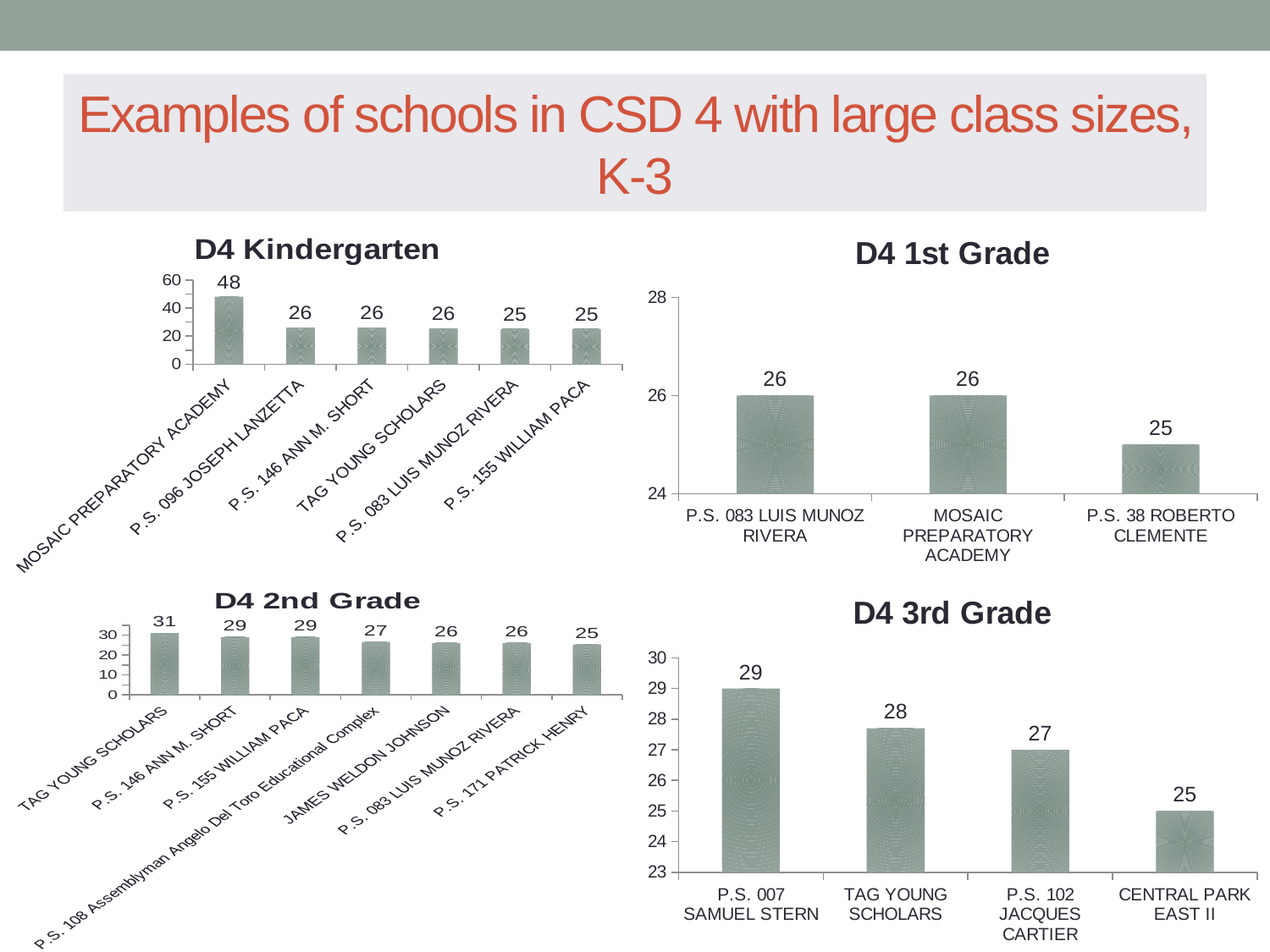
In the D4 3rd Grade chart, which is larger, P.S. 007 SAMUEL STERN or CENTRAL PARK EAST II? P.S. 007 SAMUEL STERN In the D4 Kindergarten chart, what is the difference between MOSAIC PREPARATORY ACADEMY and P.S. 155 WILLIAM PACA? 23 In the D4 Kindergarten chart, what is the value for MOSAIC PREPARATORY ACADEMY? 48 In the D4 3rd Grade chart, what is the value for P.S. 102 JACQUES CARTIER? 27 In the D4 2nd Grade chart, what is the value for TAG YOUNG SCHOLARS? 31 In the D4 1st Grade chart, which school has the lowest value? P.S. 38 ROBERTO CLEMENTE In the D4 1st Grade chart, what is the value for P.S. 38 ROBERTO CLEMENTE? 25 How many schools are shown in the D4 Kindergarten chart? 6 In the D4 2nd Grade chart, which school has the lowest value? P.S. 171 PATRICK HENRY In the D4 Kindergarten chart, which school has the highest value? MOSAIC PREPARATORY ACADEMY How many schools are shown in the D4 1st Grade chart? 3 What kind of chart is the D4 3rd Grade chart? Bar chart